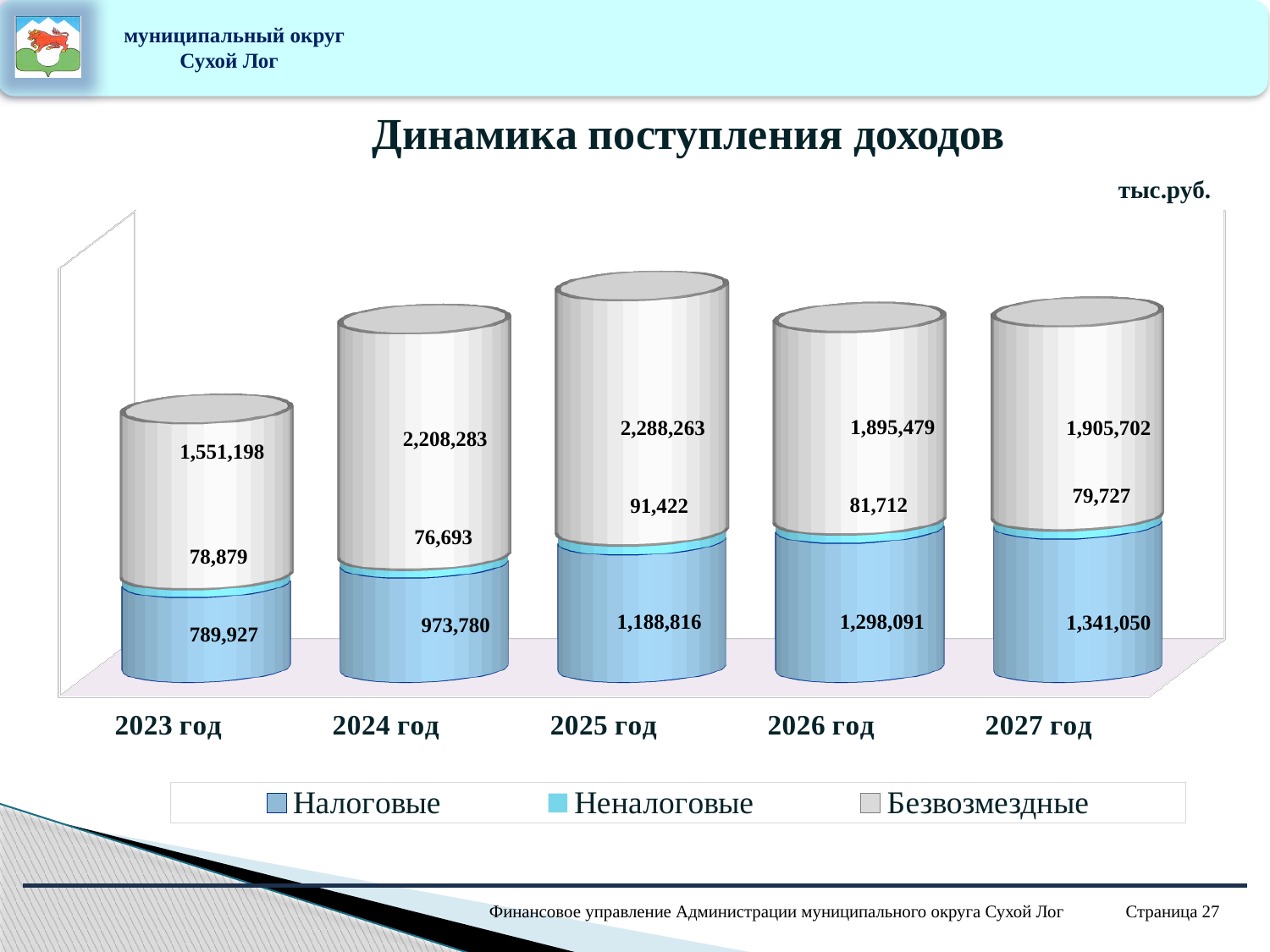
In which year is the Налоговые value highest? 2027 год What is the value for Неналоговые in 2027 год? 79,727 What is the value for Налоговые in 2023 год? 789,927 How many years are shown on the x axis? 5 What kind of chart is shown on the slide? Stacked bar chart What is the value for Безвозмездные in 2025 год? 2,288,263 Which is larger: Безвозмездные in 2024 год or Безвозмездные in 2026 год? 2024 год Do the Налоговые values rise or fall from 2023 год to 2027 год? Rise In which year is the Неналоговые value highest? 2025 год In which year is the Неналоговые value lowest? 2024 год How many series does the legend list? 3 What is the difference between the Налоговые values for 2027 год and 2023 год? 551,123